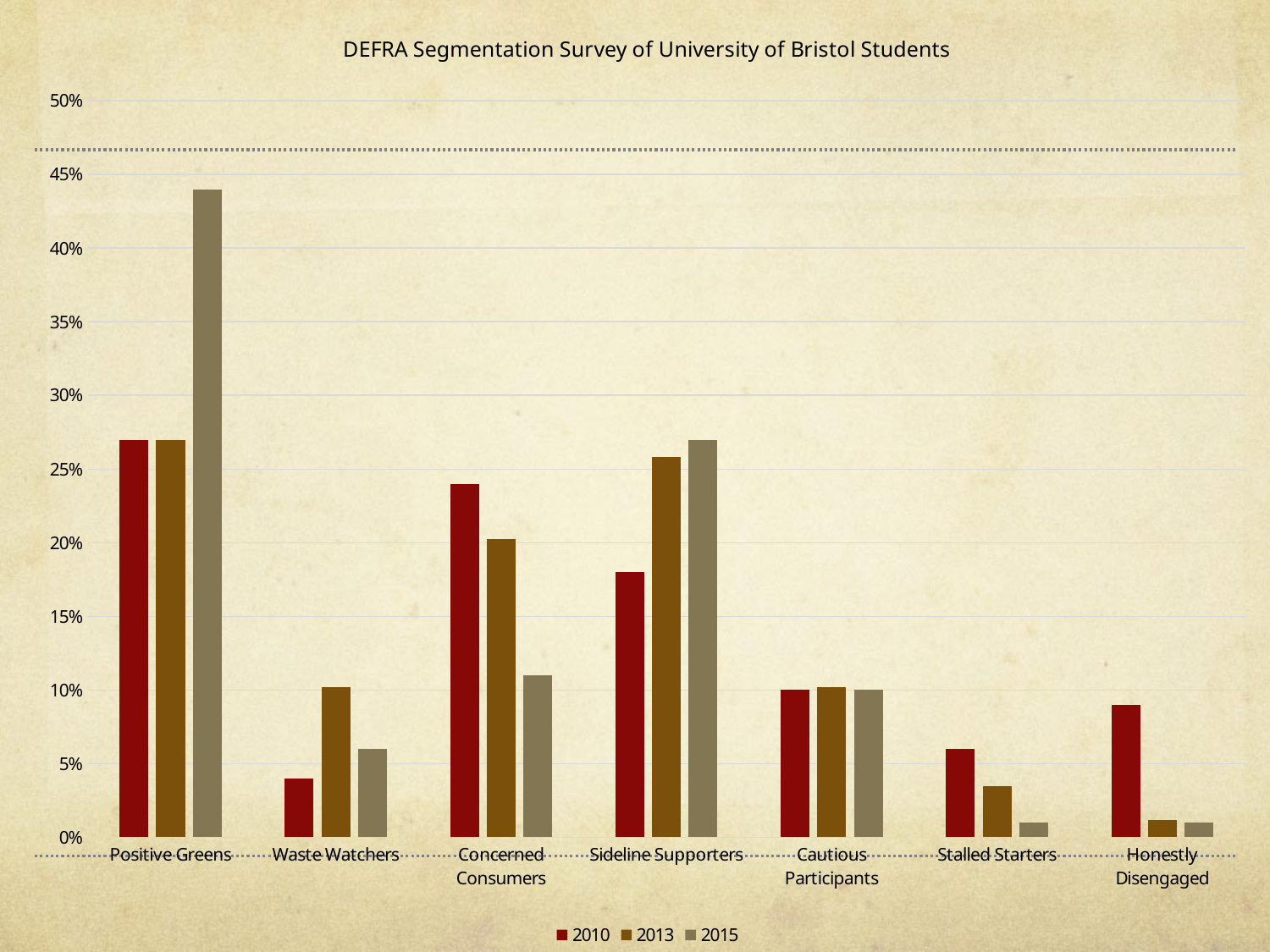
Which category has the lowest value for the 2010 series? Waste Watchers Is the 2015 value for Positive Greens greater or less than 40%? greater For Concerned Consumers, do the values rise or fall from 2010 to 2013 to 2015? fall What is the title of the chart? DEFRA Segmentation Survey of University of Bristol Students Is the 2013 value for Waste Watchers greater or less than 5%? greater For Sideline Supporters, which is larger: the 2010 value or the 2013 value? 2013 How many segment categories are shown along the x axis? 7 What kind of chart is shown on the slide? Bar chart Which category has the highest value for the 2015 series? Positive Greens How many series does the legend list? 3 Is the 2010 value for Concerned Consumers greater or less than 20%? greater For the 2010 series, which is larger: Honestly Disengaged or Stalled Starters? Honestly Disengaged